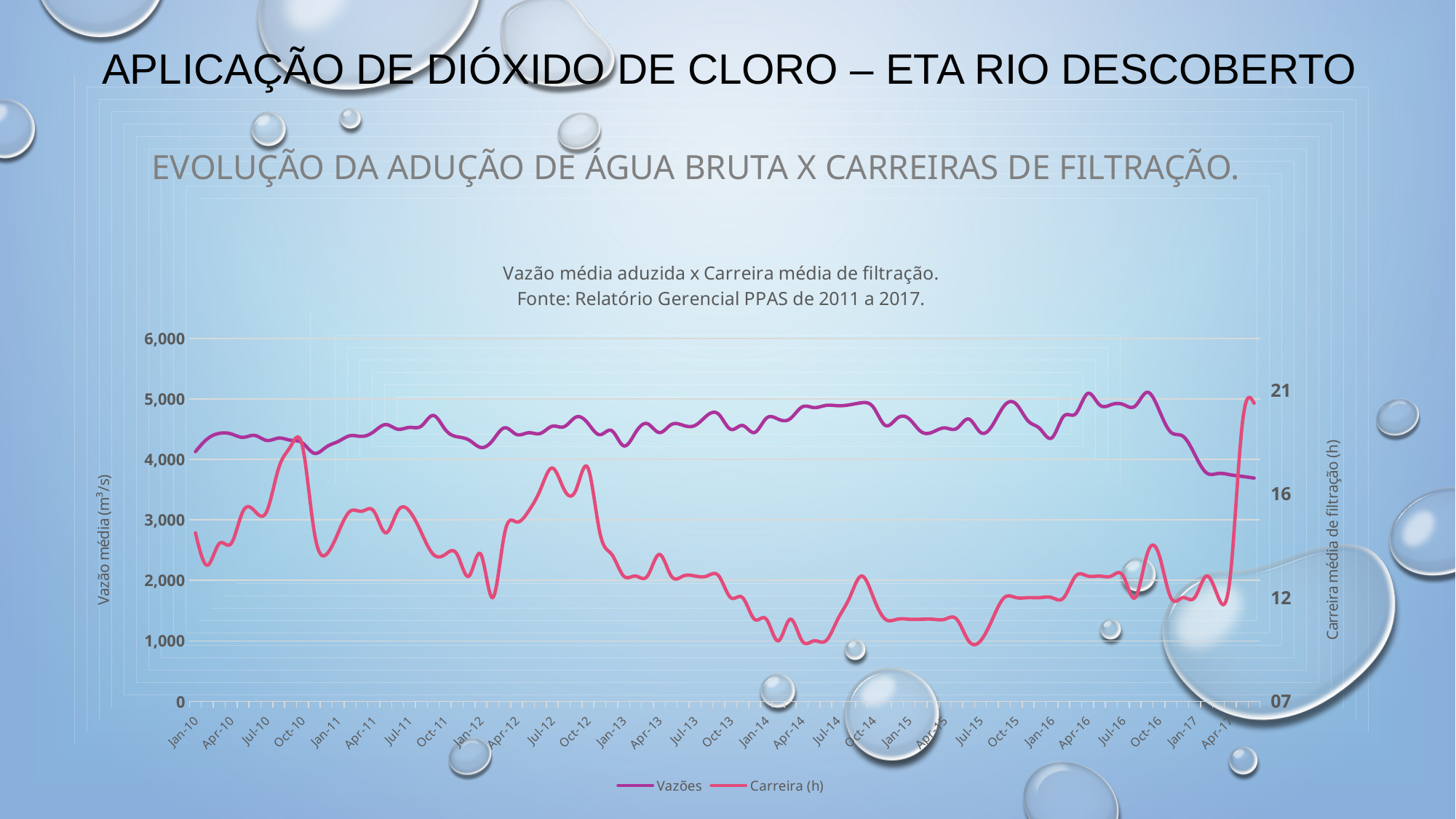
Is the Carreira (h) value at Apr-17 greater or less than 16 on the right axis? less Does the Carreira (h) series rise or fall between Jan-17 and Apr-17? rise How many series does the legend list? 2 What are the two series named in the legend? Vazões and Carreira (h) Is the Vazões value at Apr-17 greater or less than 4,000? less Is the Vazões value at Jan-14 greater or less than 4,000? greater What is the title printed above the chart? Vazão média aduzida x Carreira média de filtração. Fonte: Relatório Gerencial PPAS de 2011 a 2017. Which is larger for the Vazões series: the value at Jan-14 or the value at Apr-17? Jan-14 What kind of chart is shown on the slide? line chart Does the Vazões series rise or fall between Oct-16 and Apr-17? fall